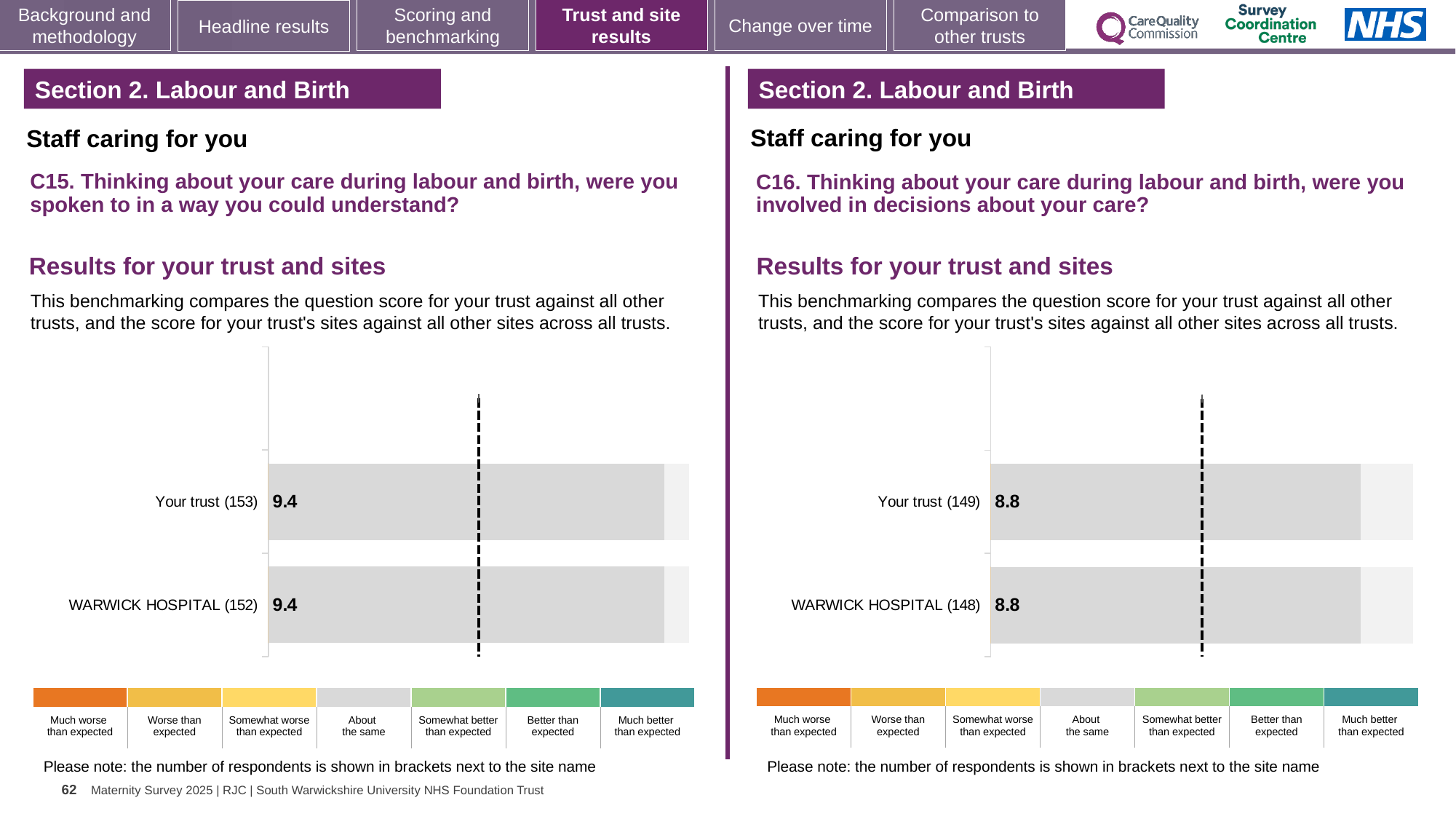
What type of chart is used for the C15 results on the left? Bar chart In the C16 chart on the right, what is the score for WARWICK HOSPITAL? 8.8 How many categories does the colour key below the C16 chart on the right list? 7 In the C15 chart on the left, what is the difference between the Your trust score and the WARWICK HOSPITAL score? 0.0 In the C16 chart on the right, how many respondents are shown in brackets for WARWICK HOSPITAL? 148 How many bars are plotted in the C15 chart on the left? 2 In the C15 chart on the left, how many respondents are shown in brackets for Your trust? 153 How many bars are plotted in the C16 chart on the right? 2 In the C15 chart on the left, what is the score for Your trust? 9.4 In the C16 chart on the right, what is the difference between the Your trust score and the WARWICK HOSPITAL score? 0.0 In the C15 chart on the left, what is the score for WARWICK HOSPITAL? 9.4 In the C16 chart on the right, what is the score for Your trust? 8.8